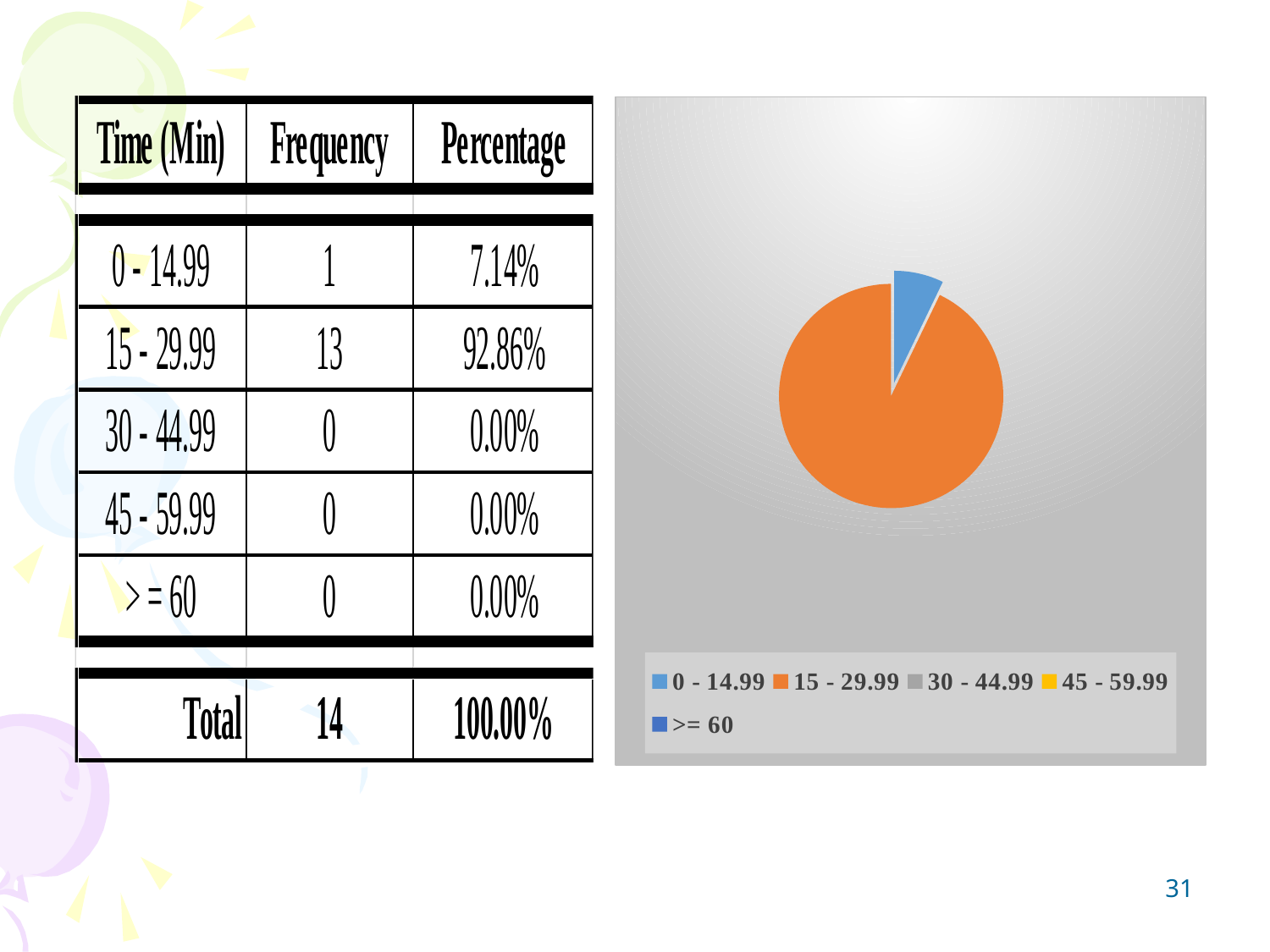
What kind of chart is shown on the right of the slide? pie chart According to the table, what share of the pie does the 15 - 29.99 category represent? 92.86% Which category has the largest slice in the pie chart? 15 - 29.99 Which is larger in the pie chart, the slice for 0 - 14.99 or the slice for 15 - 29.99? 15 - 29.99 What is the frequency for the 15 - 29.99 category in the table? 13 What is the frequency for the 0 - 14.99 category in the table? 1 Which category is shown by the small blue slice in the pie chart? 0 - 14.99 According to the table, what share of the pie does the 0 - 14.99 category represent? 7.14% What is the total frequency shown in the table? 14 What is the difference in frequency between the 15 - 29.99 and 0 - 14.99 categories? 12 Which category is shown by the orange slice in the pie chart? 15 - 29.99 How many categories does the pie chart's legend list? 5